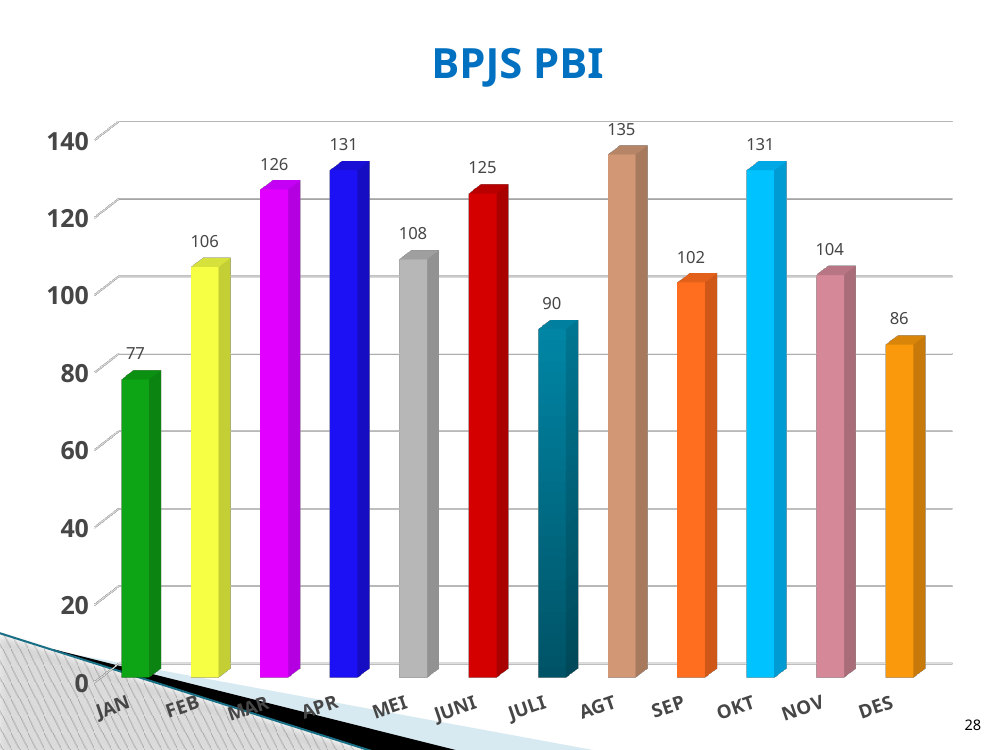
What is the value for JULI? 90 What is the title of the chart? BPJS PBI Which is larger, the value for JUNI or the value for SEP? JUNI What is the difference between the values for MAR and FEB? 20 What is the value for AGT? 135 Which month has the lowest value? JAN Which month has the highest value? AGT What kind of chart is shown? bar chart What is the difference between the values for AGT and JAN? 58 How many months are shown on the x axis? 12 Is the value for DES greater or less than 100? less What is the value for JAN? 77